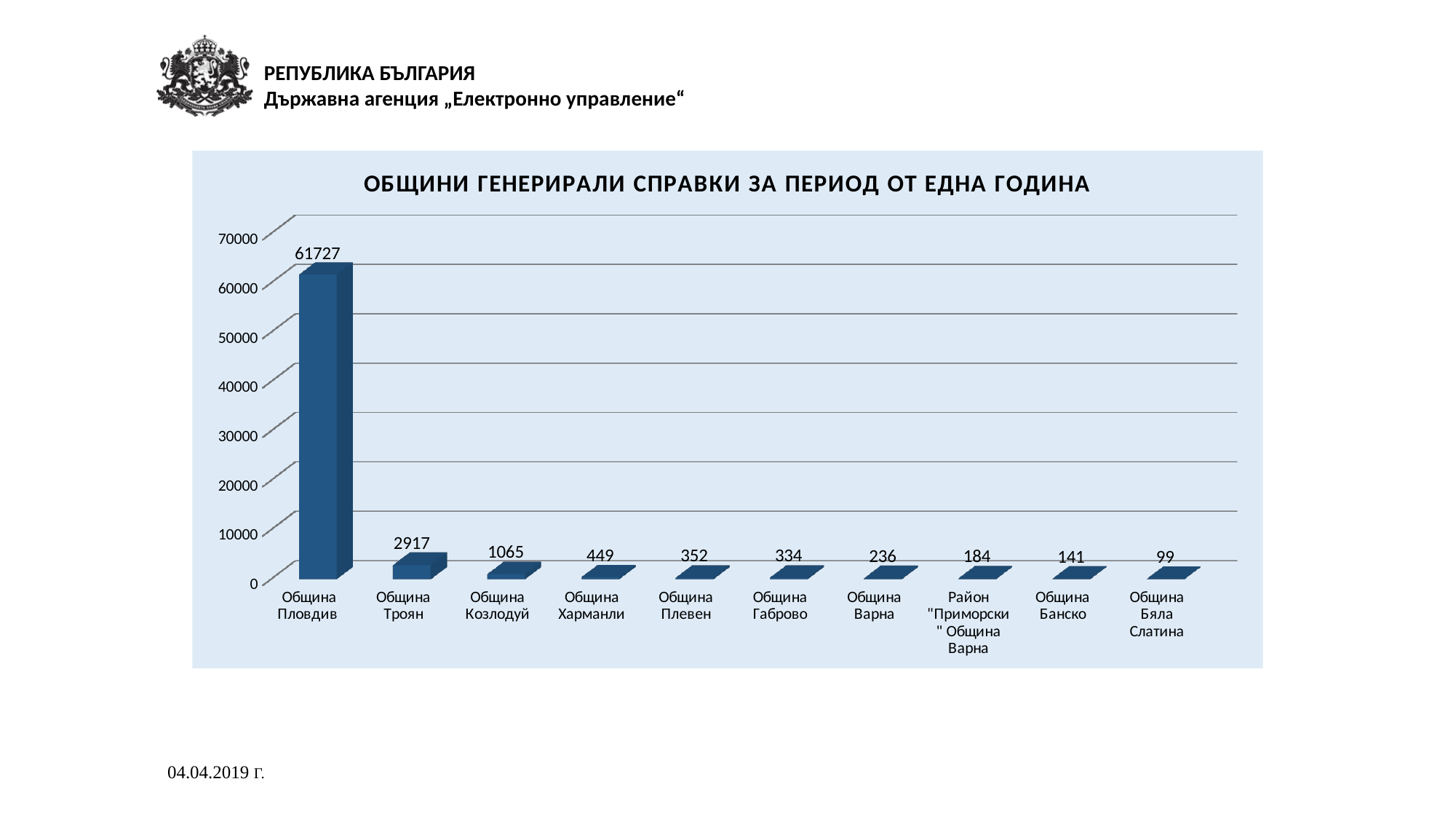
Which category has the lowest value? Община Бяла Слатина What is the value for Община Габрово? 334 What is the value for Община Троян? 2917 What is the value for Община Пловдив? 61727 Which is larger, the value for Община Харманли or the value for Община Плевен? Община Харманли Is the value for Община Пловдив greater or less than 60000? greater What is the value for Район "Приморски" Община Варна? 184 What is the title of the chart? ОБЩИНИ ГЕНЕРИРАЛИ СПРАВКИ ЗА ПЕРИОД ОТ ЕДНА ГОДИНА What is the difference between the values for Община Троян and Община Козлодуй? 1852 How many categories are shown in the chart? 10 What kind of chart is shown on the slide? bar chart Which category has the highest value? Община Пловдив